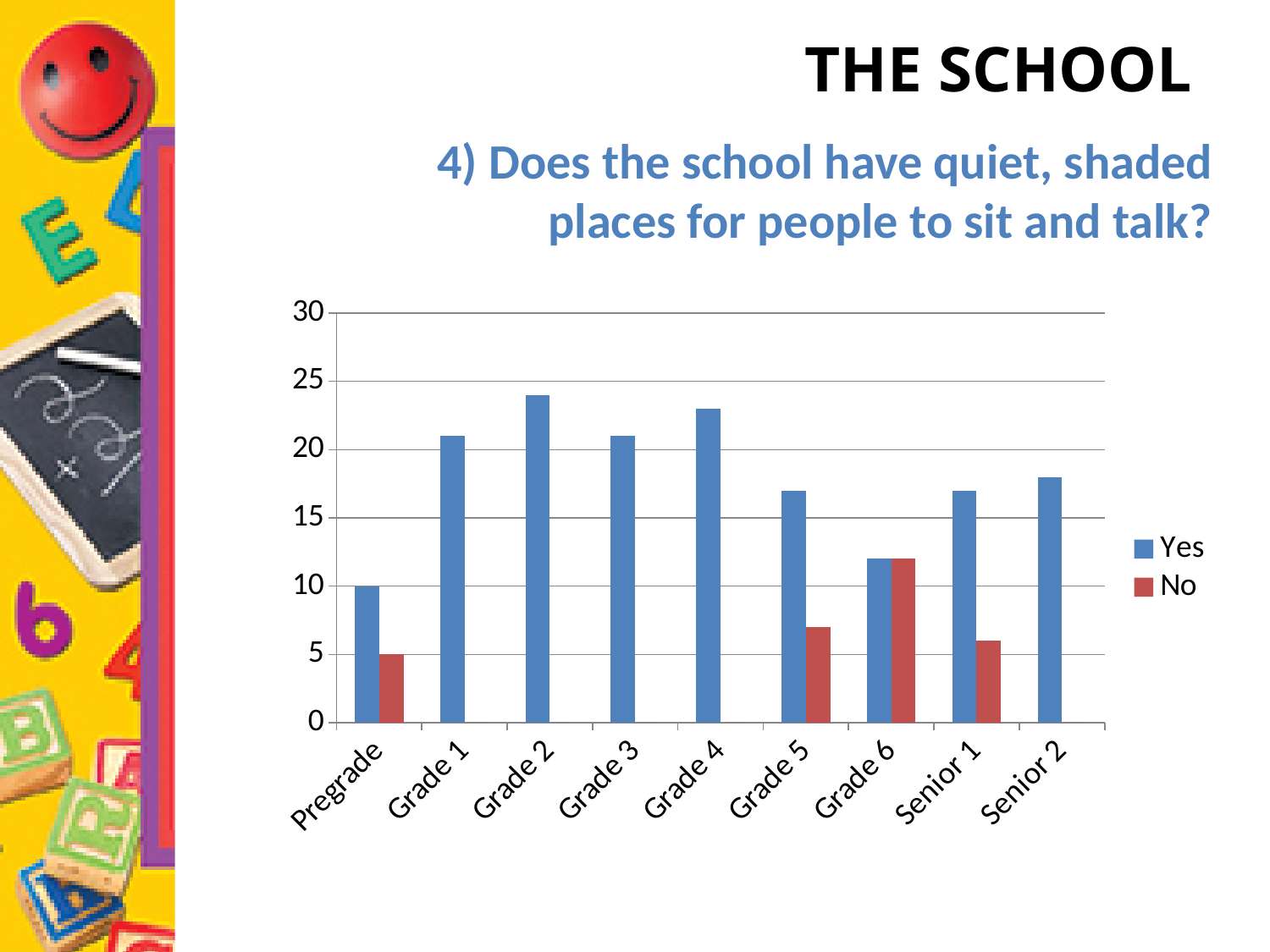
Which category has the lowest Yes value? Pregrade What is the No value for Pregrade? 5 Is the Yes value for Grade 2 greater or less than 20? greater Is the Yes value for Senior 2 greater or less than 20? less Which colour represents the No series in the legend? red What is the Yes value for Pregrade? 10 What kind of chart is shown on the slide? bar chart Which category has the highest No value? Grade 6 Is the No value for Grade 5 greater or less than 10? less How many grade categories are shown on the x axis? 9 Which is larger, the Yes value for Grade 1 or the Yes value for Grade 5? Grade 1 How many series does the legend list? 2